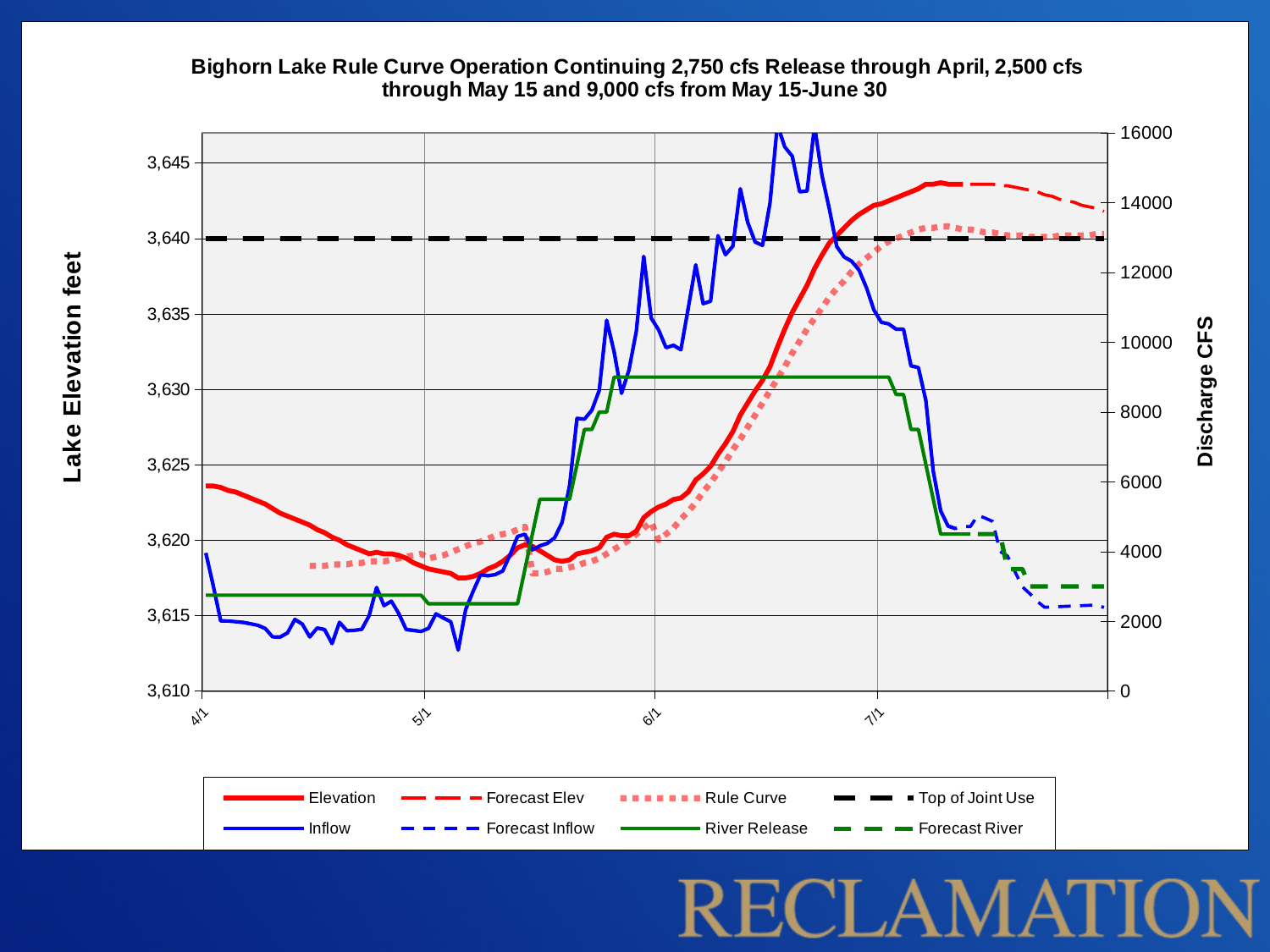
Does the Elevation line rise or fall between 6/1 and 7/1? Rise At what lake elevation does the Top of Joint Use line sit? 3,640 Is the peak Elevation value greater or less than 3,645? less Is the Elevation value on 5/1 greater or less than 3,620? less Is the Elevation value on 4/1 greater or less than 3,620? greater What is the title of the left-hand vertical axis? Lake Elevation feet What is the title of the right-hand vertical axis? Discharge CFS What kind of chart is shown on the slide? Line chart How many series does the legend list? 8 Does the Elevation line rise or fall between 4/1 and 5/1? Fall Which is larger, the Elevation on 4/1 or the Elevation on 5/1? Elevation on 4/1